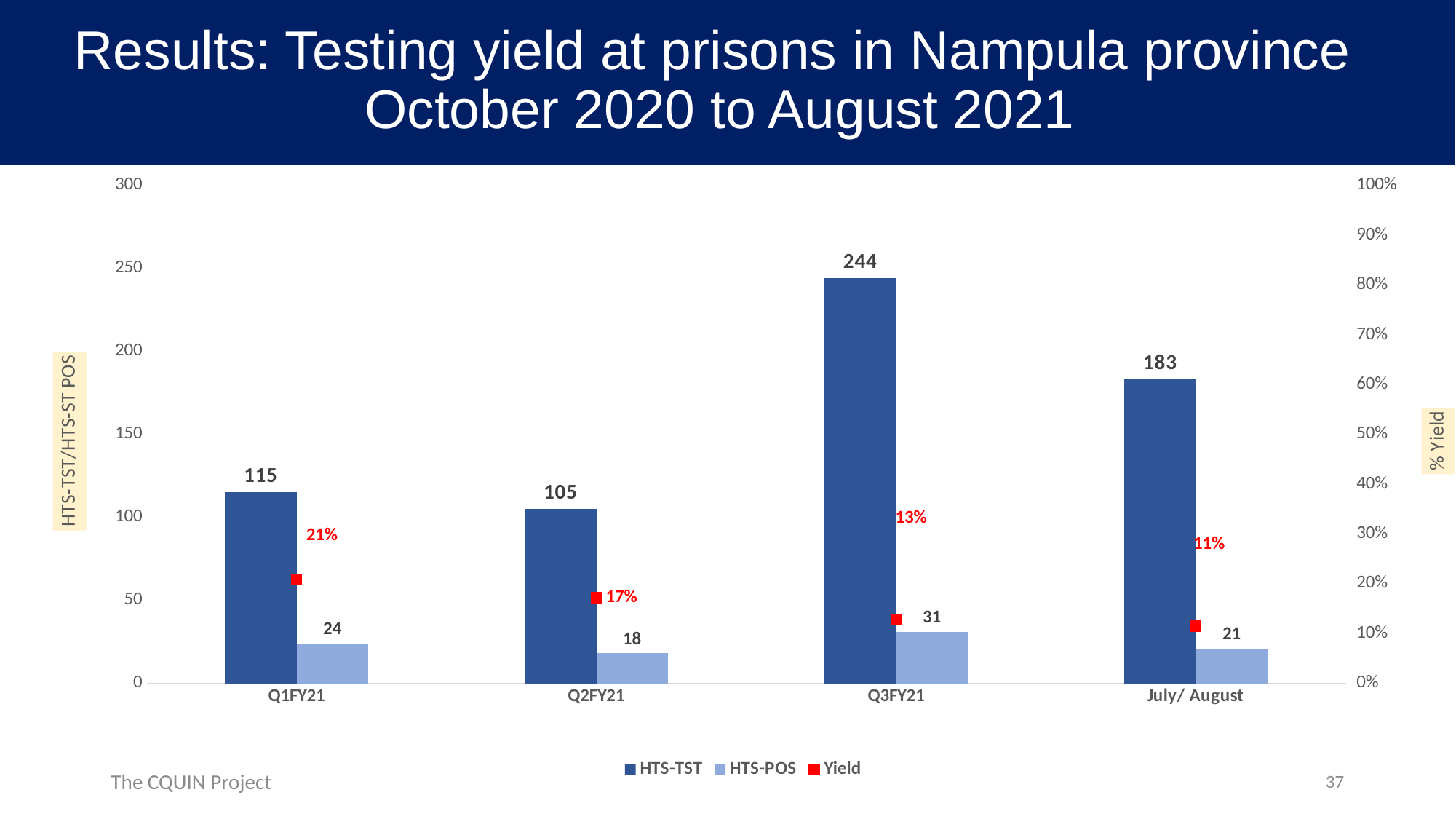
What is the difference between the HTS-TST values for Q3FY21 and July/ August? 61 What is the Yield for Q1FY21? 21% How many series does the legend list? 3 What kind of chart is used for the HTS-TST and HTS-POS series? Bar chart Which period has the lowest Yield? July/ August How many periods are shown on the x axis? 4 Which is larger, the HTS-POS value for Q1FY21 or for Q3FY21? Q3FY21 Does the Yield rise or fall from Q1FY21 to July/ August? Fall Which period has the highest HTS-TST value? Q3FY21 What is the HTS-TST value for Q3FY21? 244 What is the label of the right-hand vertical axis? % Yield What is the HTS-POS value for Q2FY21? 18